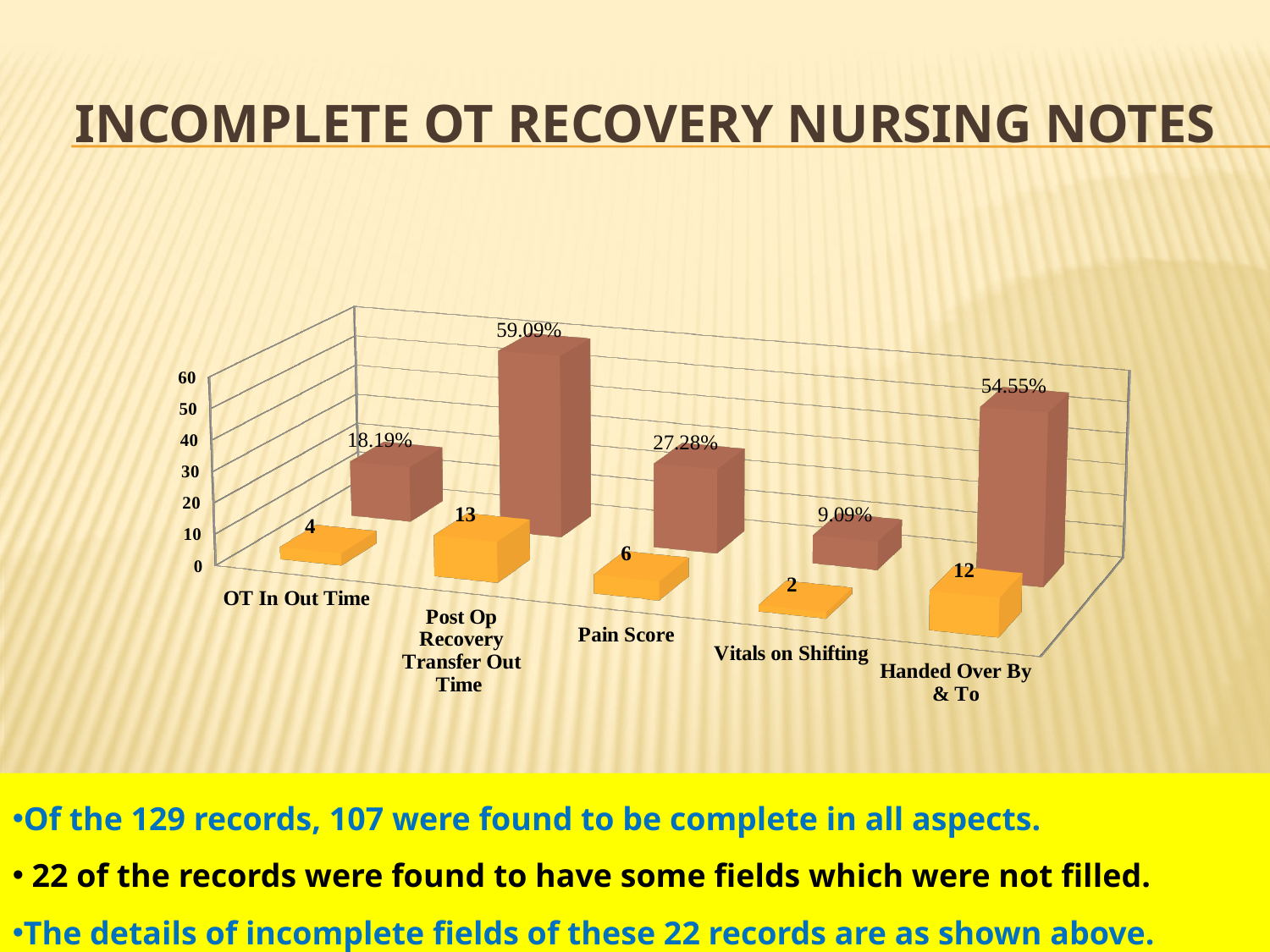
What is the title of the slide containing the chart? INCOMPLETE OT RECOVERY NURSING NOTES Which category has the highest percentage value? Post Op Recovery Transfer Out Time What is the percentage value labelled for Vitals on Shifting? 9.09% What type of chart is shown on the slide? bar chart What is the count value labelled on the orange bar for Handed Over By & To? 12 What is the total of the count values shown on the orange bars across all five categories? 37 Which category has the lowest count value on the orange bars? Vitals on Shifting Which is larger, the percentage value for Pain Score or the percentage value for OT In Out Time? Pain Score How many categories are shown on the x axis of the chart? 5 What is the count value labelled on the orange bar for Pain Score? 6 What is the difference between the count values for Post Op Recovery Transfer Out Time and OT In Out Time? 9 What is the percentage value labelled for Post Op Recovery Transfer Out Time? 59.09%